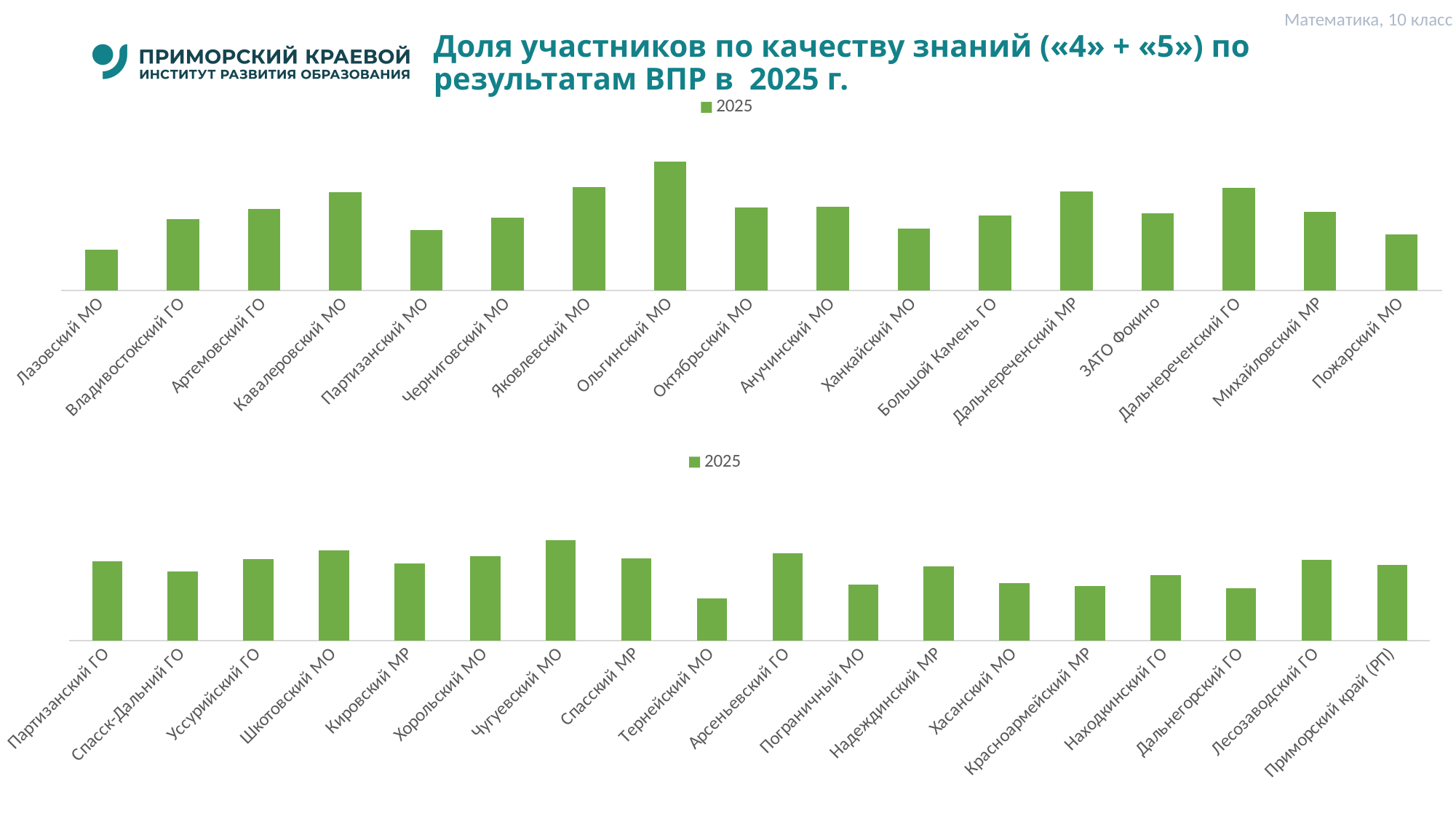
In the top chart, which is larger: the value for Яковлевский МО or for Ханкайский МО? Яковлевский МО In the bottom chart, which is larger: the value for Арсеньевский ГО or for Пограничный МО? Арсеньевский ГО In the top chart, which is larger: the value for Кавалеровский МО or for Партизанский МО? Кавалеровский МО In the top chart, which category has the lowest value? Лазовский МО How many series does the legend of the top chart list? 1 In the bottom chart, which category has the highest value? Чугуевский МО In the bottom chart, which category has the lowest value? Тернейский МО In the top chart, which category has the highest value? Ольгинский МО What is the legend entry shown for the bottom chart? 2025 How many categories are shown in the bottom chart? 18 How many categories are shown in the top chart? 17 What kind of chart is the bottom chart? Bar chart